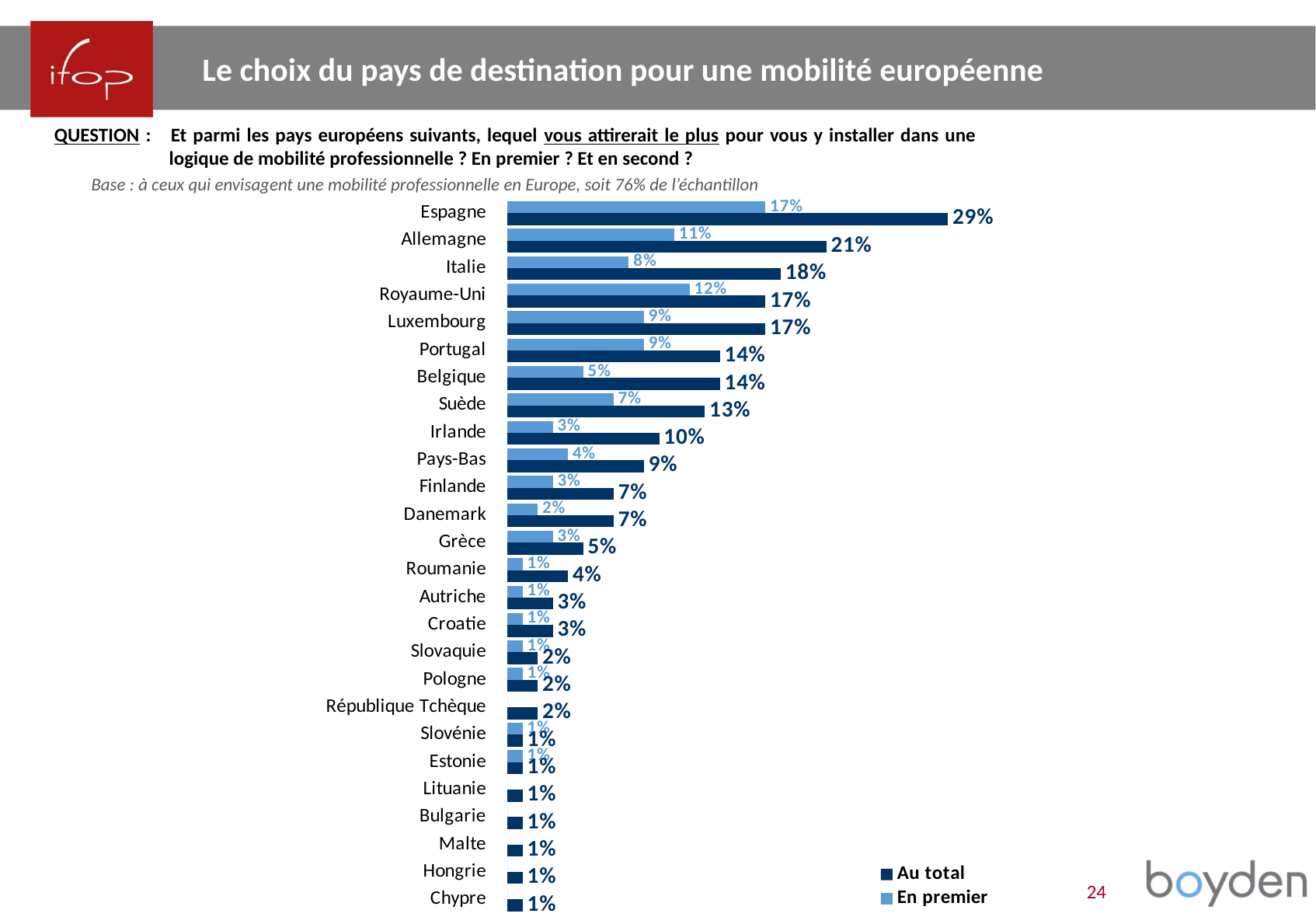
Which country has the highest 'Au total' value? Espagne What is the difference between the 'Au total' and 'En premier' values for Italie? 10% What is the 'Au total' value for Espagne? 29% What kind of chart is shown on the slide? Bar chart Which has the larger 'En premier' value, Royaume-Uni or Luxembourg? Royaume-Uni How many series does the legend list? 2 Which has the larger 'Au total' value, Irlande or Pays-Bas? Irlande What is the 'En premier' value for Allemagne? 11% What is the 'Au total' value for Suède? 13% What is the difference between the 'Au total' values for Espagne and Allemagne? 8% How many countries are listed in the chart? 26 What is the 'En premier' value for Royaume-Uni? 12%